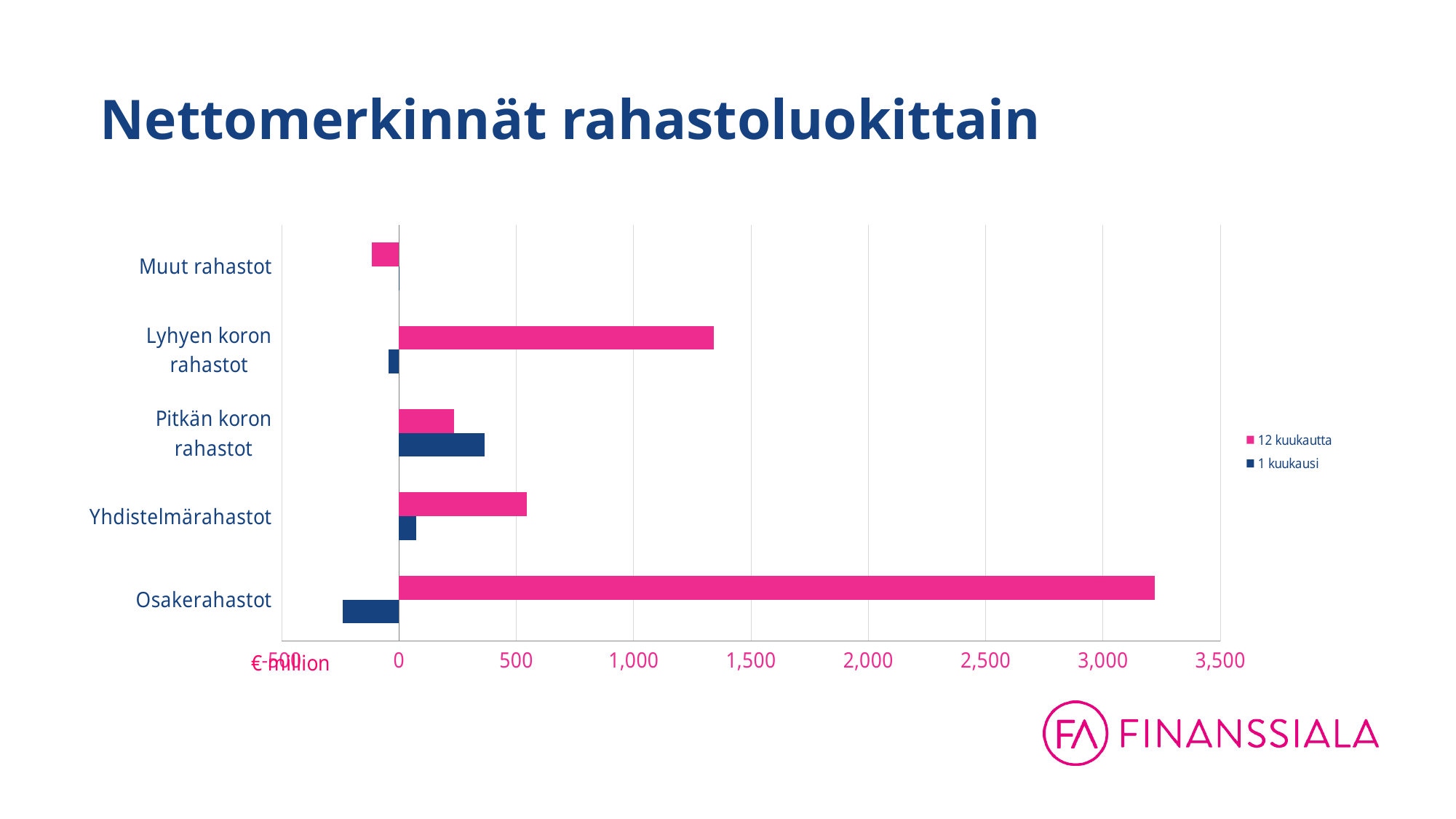
For Pitkän koron rahastot, which series has the larger value, 12 kuukautta or 1 kuukausi? 1 kuukausi Is the 12 kuukautta value for Osakerahastot greater or less than 3,000? greater Which category has the highest value for the 1 kuukausi series? Pitkän koron rahastot How many fund categories are shown on the chart? 5 What is the title of the chart? Nettomerkinnät rahastoluokittain Which category has the highest value for the 12 kuukautta series? Osakerahastot Which category has the lowest value for the 12 kuukautta series? Muut rahastot Is the 1 kuukausi value for Osakerahastot greater or less than 0? less How many series does the legend list? 2 What kind of chart is shown on the slide? bar chart Is the 12 kuukautta value for Lyhyen koron rahastot greater or less than 1,000? greater Which category has the lowest value for the 1 kuukausi series? Osakerahastot